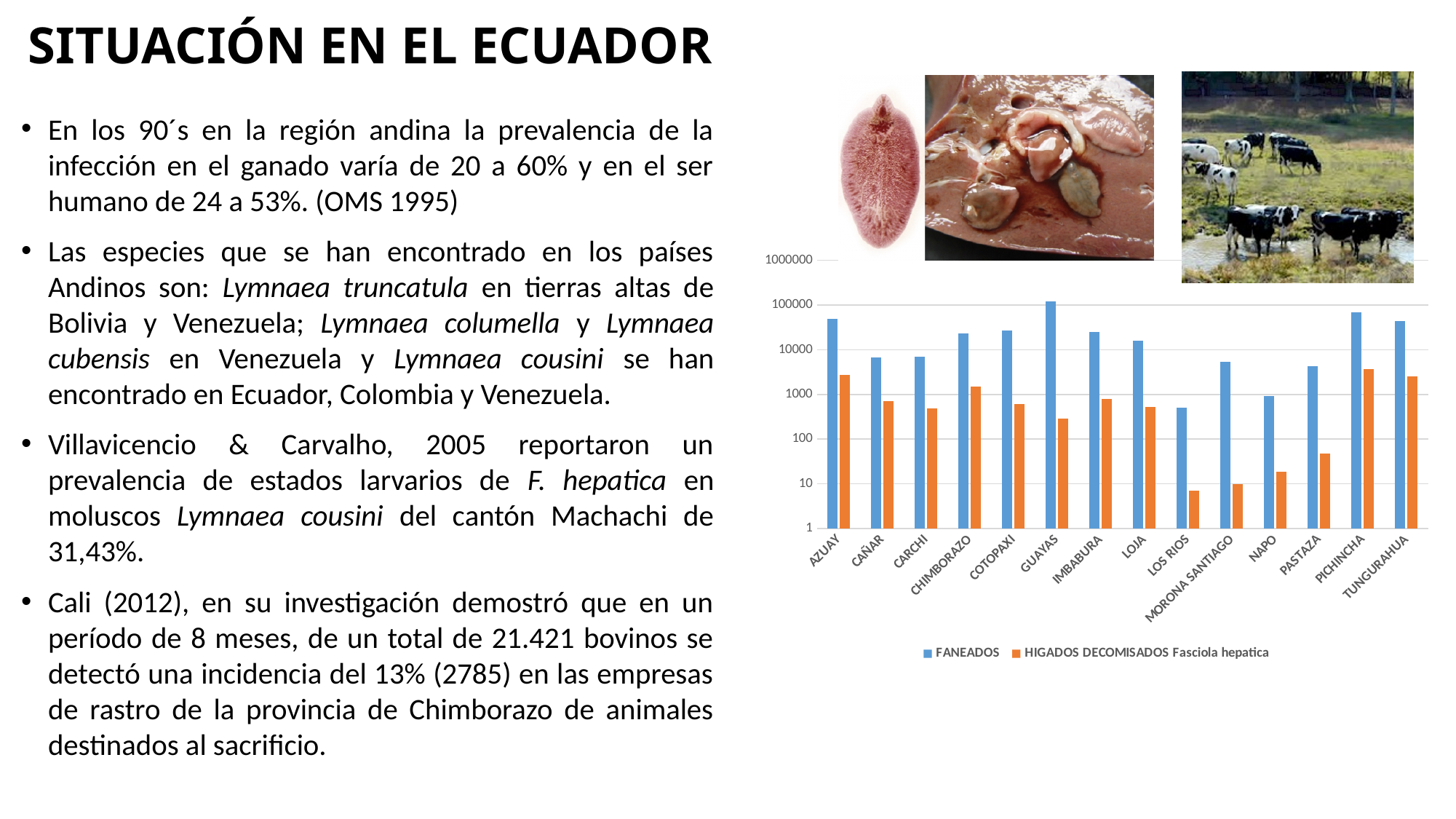
Which province has the highest FANEADOS value? GUAYAS Is the HIGADOS DECOMISADOS Fasciola hepatica value for LOS RIOS greater or less than 10? less Is the HIGADOS DECOMISADOS Fasciola hepatica value for CHIMBORAZO greater or less than 1000? greater Which is larger for PICHINCHA: the FANEADOS value or the HIGADOS DECOMISADOS Fasciola hepatica value? FANEADOS How many provinces (categories) are shown on the x axis of the chart? 14 Which colour represents the FANEADOS series in the chart? blue Which province has the lowest HIGADOS DECOMISADOS Fasciola hepatica value? LOS RIOS Which province has the lowest FANEADOS value? LOS RIOS What kind of chart is shown on the slide? bar chart Is the HIGADOS DECOMISADOS Fasciola hepatica value for PASTAZA greater or less than 100? less How many series does the chart legend list? 2